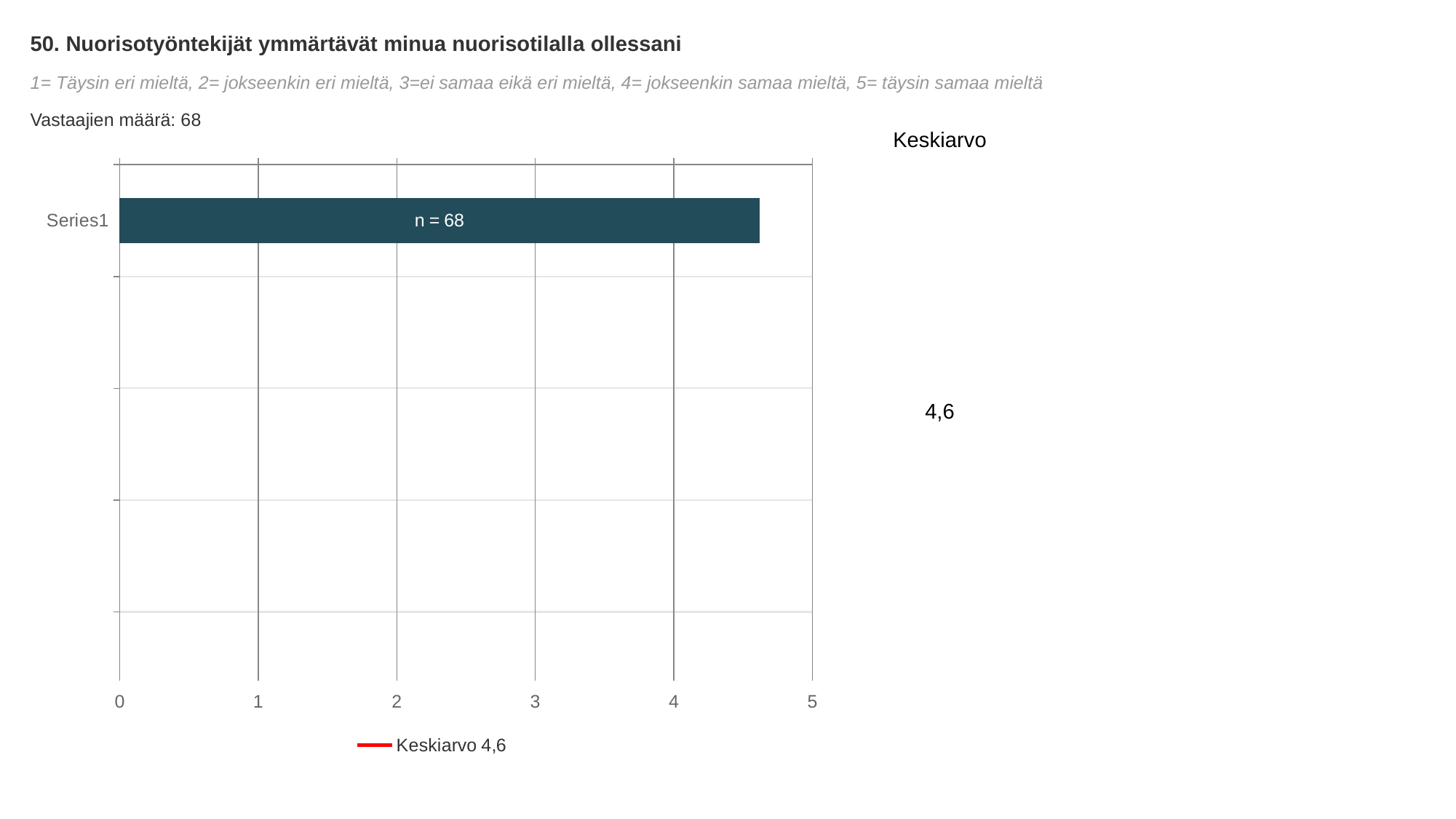
What does the legend entry below the chart say? Keskiarvo 4,6 Is the value for the Series1 bar greater or less than 4? greater What kind of chart is shown on the slide? bar chart What data label is printed on the Series1 bar? n = 68 Is the value for the Series1 bar greater or less than 3? greater How many bars does the chart show? 1 How many respondents (Vastaajien määrä) are reported on the slide? 68 What is the Keskiarvo (mean) value shown on the slide? 4,6 What is the label of the single category on the vertical axis? Series1 What is the title of the slide's chart? 50. Nuorisotyöntekijät ymmärtävät minua nuorisotilalla ollessani Is the value for the Series1 bar greater or less than 5? less